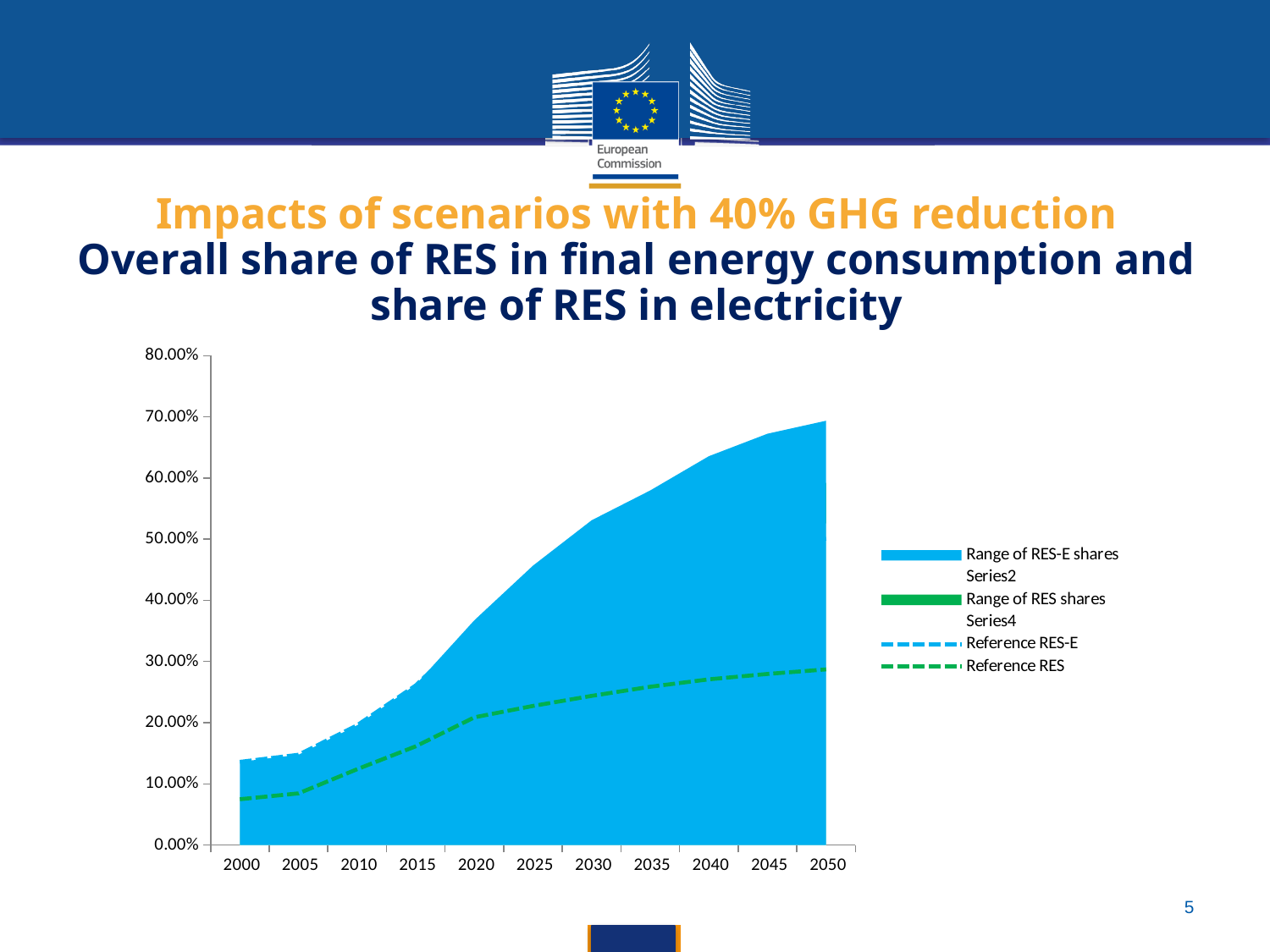
Does the Reference RES line rise or fall from 2000 to 2050? rise Is the upper edge of the Range of RES-E shares area in 2050 greater or less than 60.00%? greater How many year ticks are labelled on the x axis of the chart? 11 What colour is the Range of RES-E shares area in the chart? blue What is the first year labelled on the x axis of the chart? 2000 Is the value of the Reference RES line in 2050 greater or less than 30.00%? less Is the value of the Reference RES line in 2000 greater or less than 10.00%? less How many entries does the chart legend list? 6 What kind of chart is shown on the slide? combination area and line chart